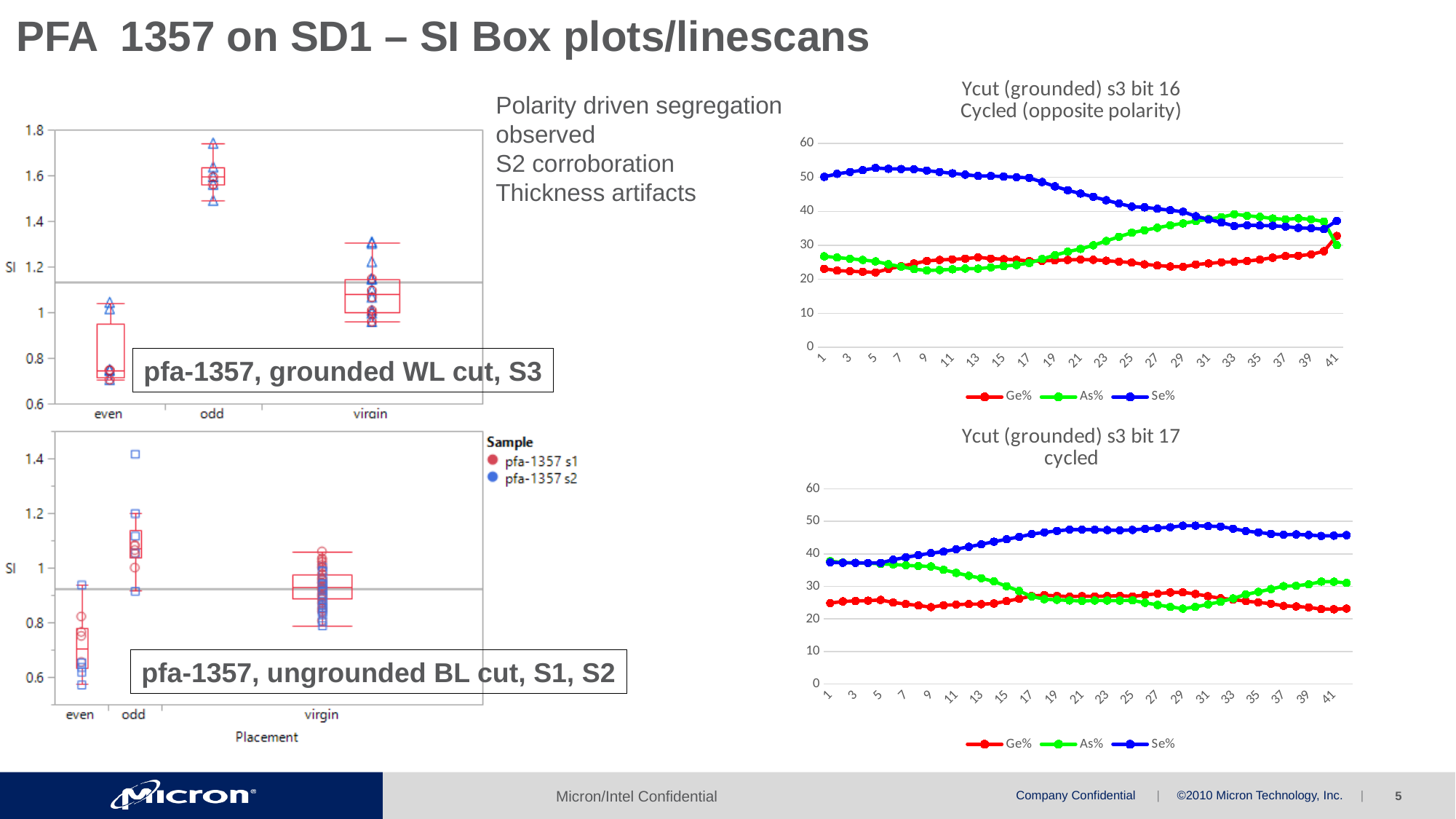
What are the legend entries of the 'Ycut (grounded) s3 bit 16' chart? Ge%, As%, Se% In the top box plot (grounded WL cut, S3), which placement has the highest SI values? odd In the 'Ycut (grounded) s3 bit 16' chart, which series has the highest value at x = 1? Se% In the 'Ycut (grounded) s3 bit 17 cycled' chart, is the Se% value at x = 29 greater or less than 40? greater What kind of chart is the 'Ycut (grounded) s3 bit 16' chart on the right? line chart In the 'Ycut (grounded) s3 bit 16' chart, does the Se% series rise or fall from x = 1 to x = 41? fall In the 'Ycut (grounded) s3 bit 17 cycled' chart, which is larger at x = 1, Se% or Ge%? Se% In the 'Ycut (grounded) s3 bit 17 cycled' chart, does the Se% series rise or fall from x = 1 to x = 29? rise In the 'Ycut (grounded) s3 bit 16' chart, is the Ge% value at x = 1 greater or less than 30? less How many placement categories are shown on the x axis of the top box plot (grounded WL cut, S3)? 3 In the 'Ycut (grounded) s3 bit 16' chart, is the Se% value at x = 1 greater or less than 40? greater How many series does the legend of the 'Ycut (grounded) s3 bit 17 cycled' chart list? 3